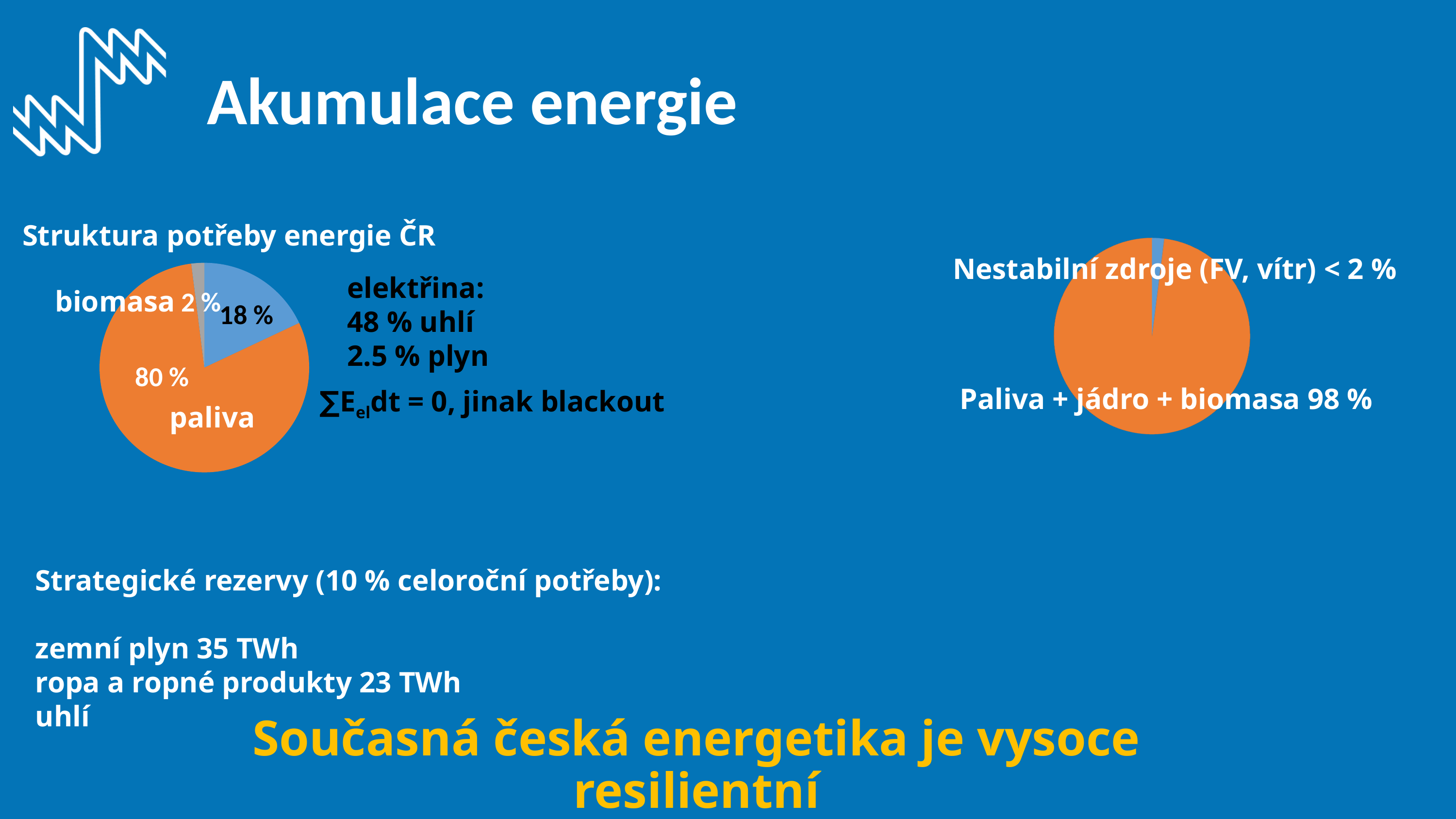
In the right pie chart, which slice is larger, 'Nestabilní zdroje (FV, vítr)' or 'Paliva + jádro + biomasa'? Paliva + jádro + biomasa In the left pie chart 'Struktura potřeby energie ČR', what share is labelled for biomasa? 2 % In the right pie chart, what share is labelled for 'Paliva + jádro + biomasa'? 98 % What kind of chart is the chart on the right side of the slide? pie chart In the left pie chart 'Struktura potřeby energie ČR', what share is labelled for elektřina? 18 % In the left pie chart 'Struktura potřeby energie ČR', which slice is the largest? paliva In the left pie chart 'Struktura potřeby energie ČR', which is larger, the elektřina slice or the biomasa slice? elektřina In the left pie chart 'Struktura potřeby energie ČR', what is the difference in percentage points between the paliva slice and the elektřina slice? 62 In the left pie chart 'Struktura potřeby energie ČR', which slice is the smallest? biomasa In the left pie chart 'Struktura potřeby energie ČR', what share is labelled for paliva? 80 % In the left pie chart 'Struktura potřeby energie ČR', what colour is the paliva slice? orange In the left pie chart 'Struktura potřeby energie ČR', how many slices does the pie have? 3